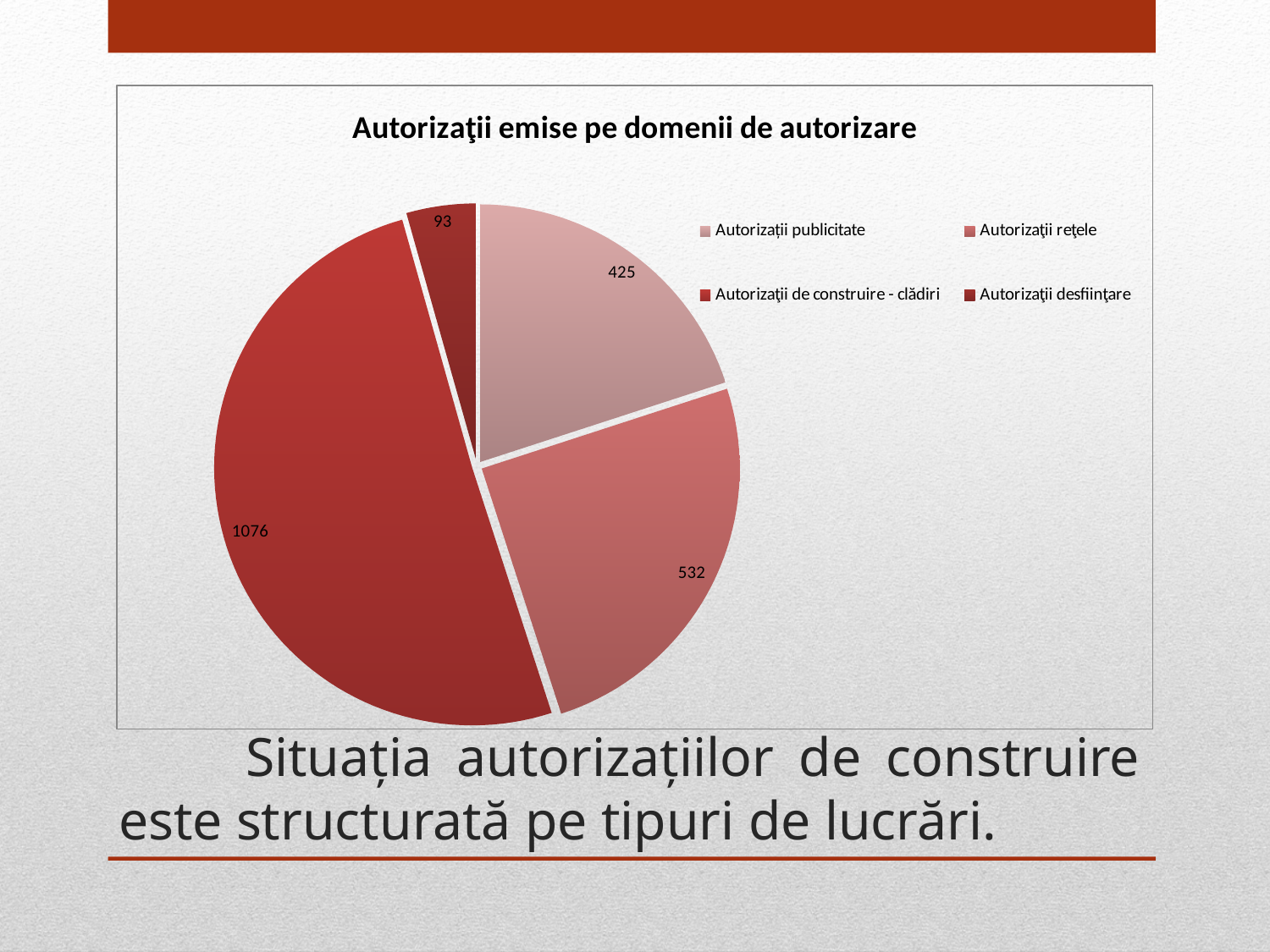
What is the value for Autorizaţii reţele? 532 What is the title of the chart? Autorizaţii emise pe domenii de autorizare What is the value for Autorizaţii desfiinţare? 93 What share of the total does Autorizaţii de construire - clădiri represent? 50.6% What type of chart is shown on the slide? pie chart Which category has the smallest slice? Autorizaţii desfiinţare How many slices does the pie chart have? 4 What is the value for Autorizaţii publicitate? 425 What is the difference between the values for Autorizaţii reţele and Autorizaţii publicitate? 107 Which category has the largest slice? Autorizaţii de construire - clădiri What is the value for Autorizaţii de construire - clădiri? 1076 Which is larger, Autorizaţii reţele or Autorizaţii publicitate? Autorizaţii reţele